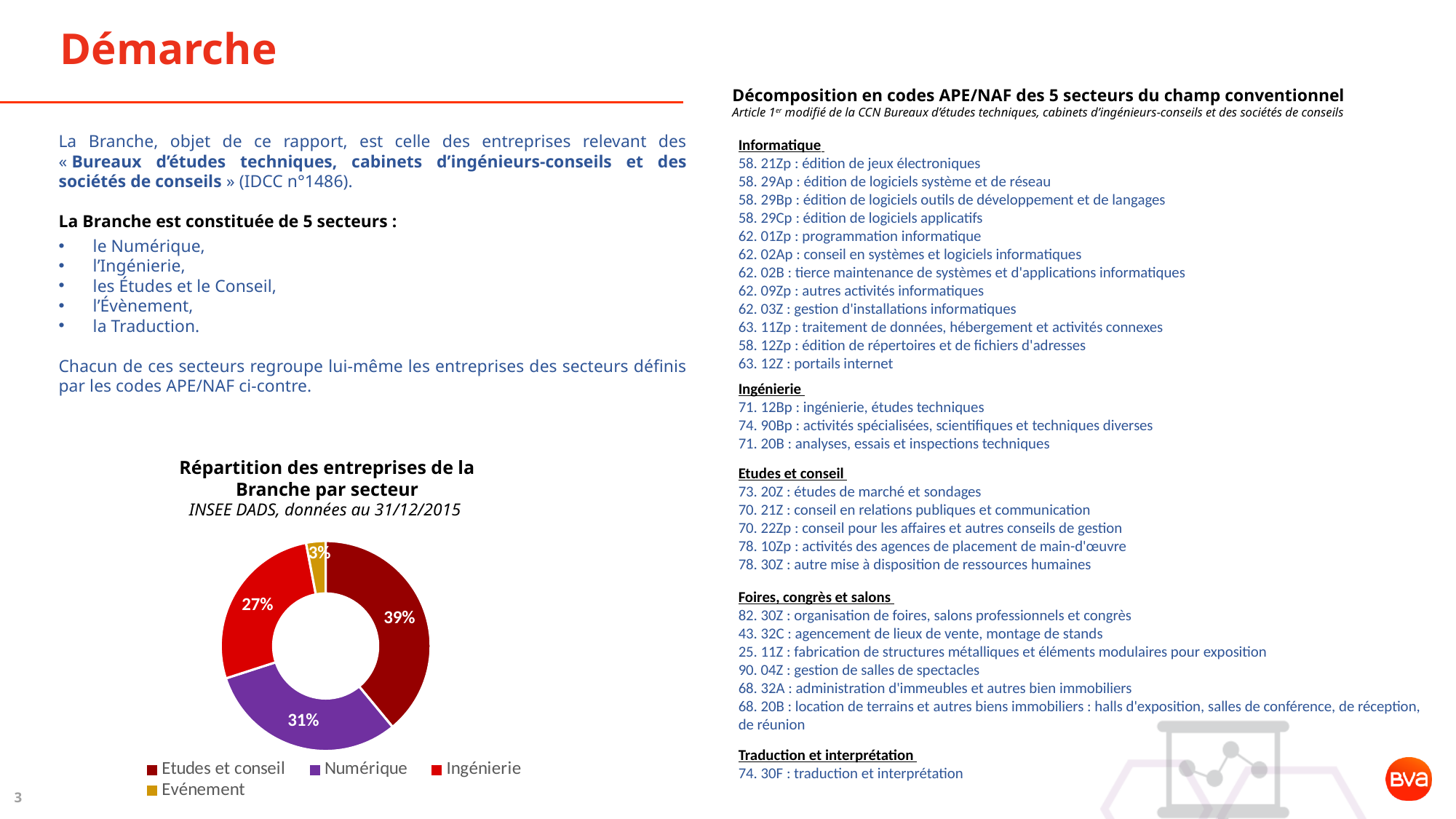
Which sector has the largest share in the chart? Etudes et conseil What is the title of the chart? Répartition des entreprises de la Branche par secteur What share of the doughnut chart does Ingénierie represent? 27% What share of the doughnut chart does Numérique represent? 31% How many sectors are shown in the chart? 4 What share of the doughnut chart does Etudes et conseil represent? 39% Which sector has a larger share, Numérique or Ingénierie? Numérique What data source and date are given under the chart title? INSEE DADS, données au 31/12/2015 What type of chart is used to show the distribution of companies by sector? Doughnut chart What share of the doughnut chart does Evénement represent? 3% What is the difference in percentage points between the Etudes et conseil share and the Ingénierie share? 12 Which sector has the smallest share in the chart? Evénement